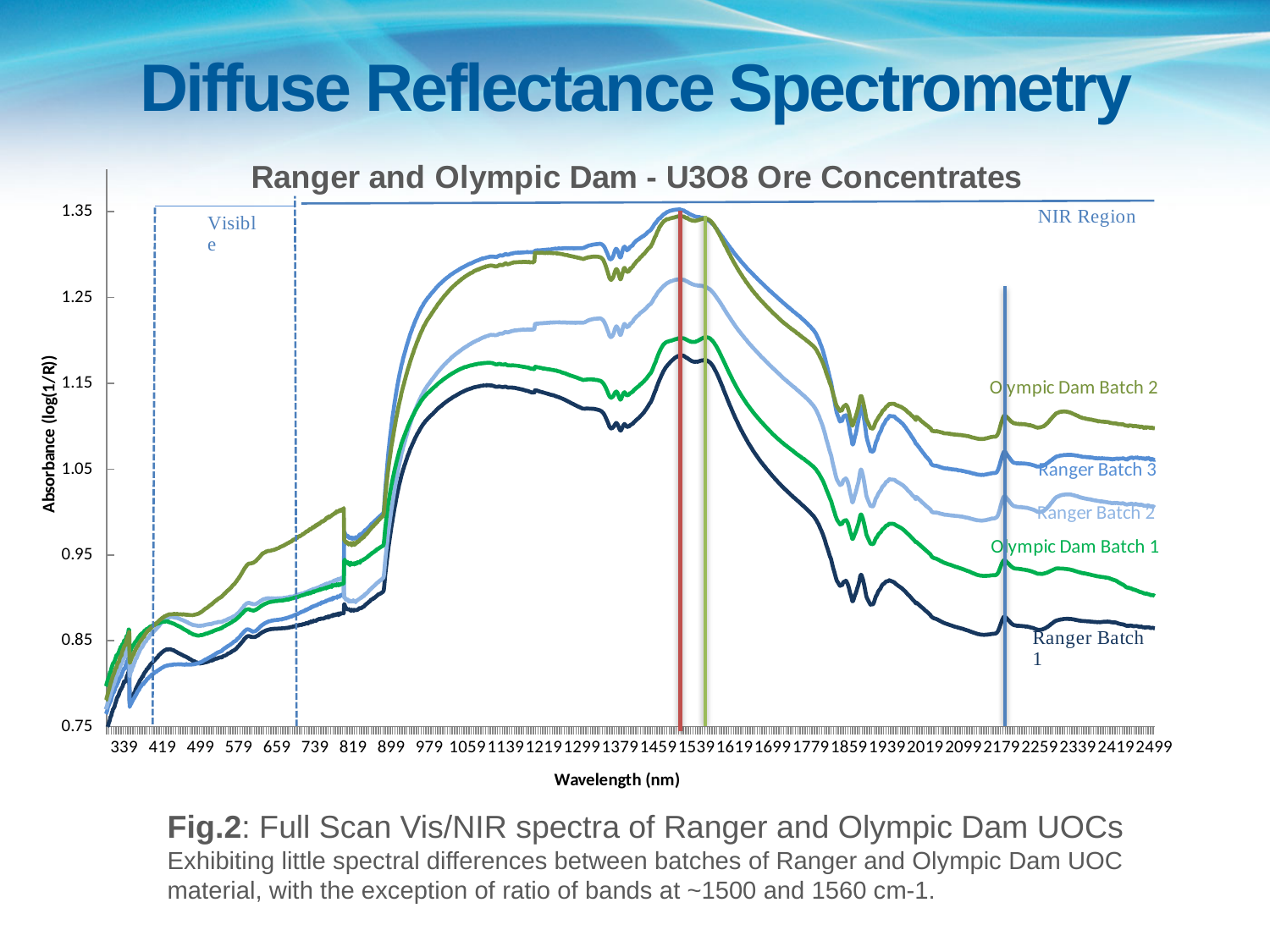
What kind of chart is shown on the slide? line chart What is the label of the x axis of the chart? Wavelength (nm) Which series has the lowest absorbance at the right end of the chart (2499 nm)? Ranger Batch 1 At 2499 nm, is the absorbance for Olympic Dam Batch 2 greater or less than 1.05? greater At 2499 nm, is the absorbance for Olympic Dam Batch 1 greater or less than 0.95? less Is the peak absorbance of Ranger Batch 1 (around 1459-1539 nm) greater or less than 1.25? less What is the title of the chart? Ranger and Olympic Dam - U3O8 Ore Concentrates Between about 1539 nm and 1859 nm, do the absorbance values rise or fall as wavelength increases? fall How many spectra (series) are plotted on the chart? 5 Which series has the highest absorbance at the right end of the chart (2499 nm)? Olympic Dam Batch 2 At 2499 nm, which has the higher absorbance, Olympic Dam Batch 2 or Ranger Batch 1? Olympic Dam Batch 2